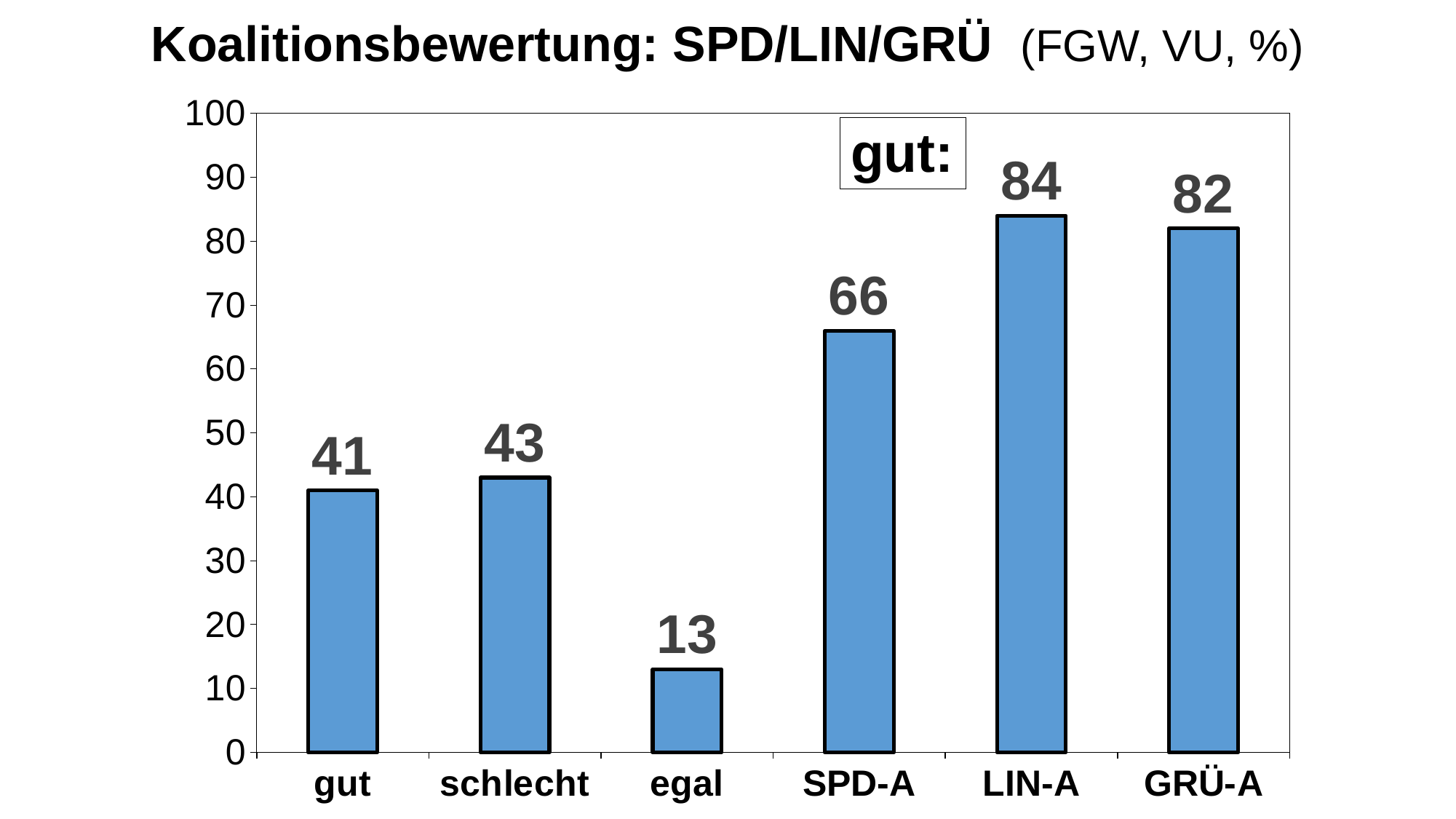
Which category has the highest value? LIN-A What is the value for LIN-A? 84 What is the title of the chart? Koalitionsbewertung: SPD/LIN/GRÜ (FGW, VU, %) Which is larger, the value for "gut" or the value for "schlecht"? schlecht What is the value for "schlecht"? 43 How many categories are shown on the x axis? 6 What is the value for SPD-A? 66 What kind of chart is this? bar chart What is the difference between the values for LIN-A and GRÜ-A? 2 Which category has the lowest value? egal What is the value for "egal"? 13 What is the value for "gut"? 41